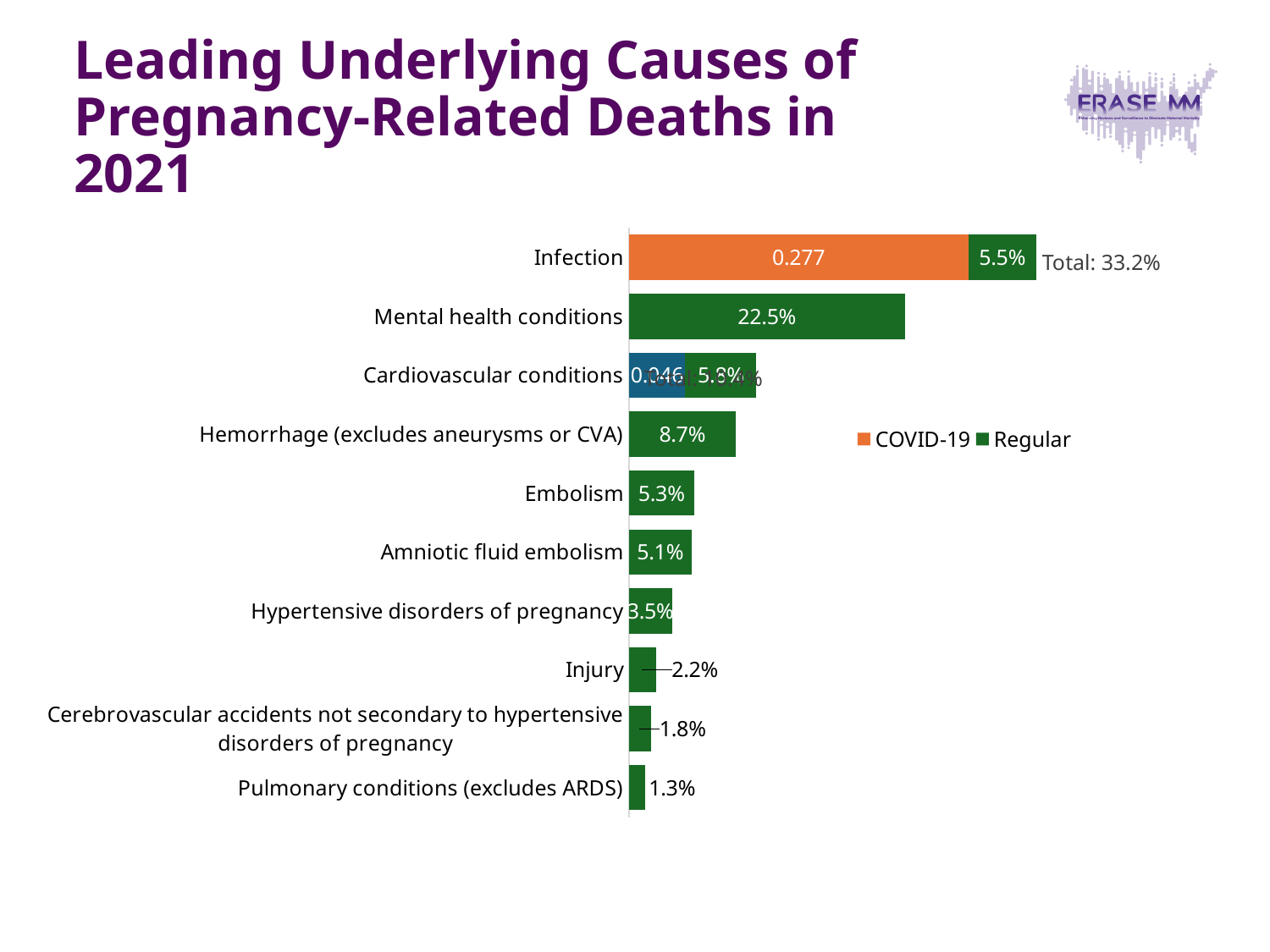
What is the difference between the values for Mental health conditions and Hemorrhage (excludes aneurysms or CVA)? 13.8% Which category has the highest total value? Infection What is the value for Hypertensive disorders of pregnancy? 3.5% What is the Regular value for Mental health conditions? 22.5% What is the total shown for Infection? 33.2% What is the Regular value for Infection? 5.5% What is the value for Pulmonary conditions (excludes ARDS)? 1.3% What is the value for Hemorrhage (excludes aneurysms or CVA)? 8.7% How many categories are shown in the chart? 10 Which category has the lowest value? Pulmonary conditions (excludes ARDS) Which is larger, the value for Embolism or for Amniotic fluid embolism? Embolism How many series does the legend list? 2